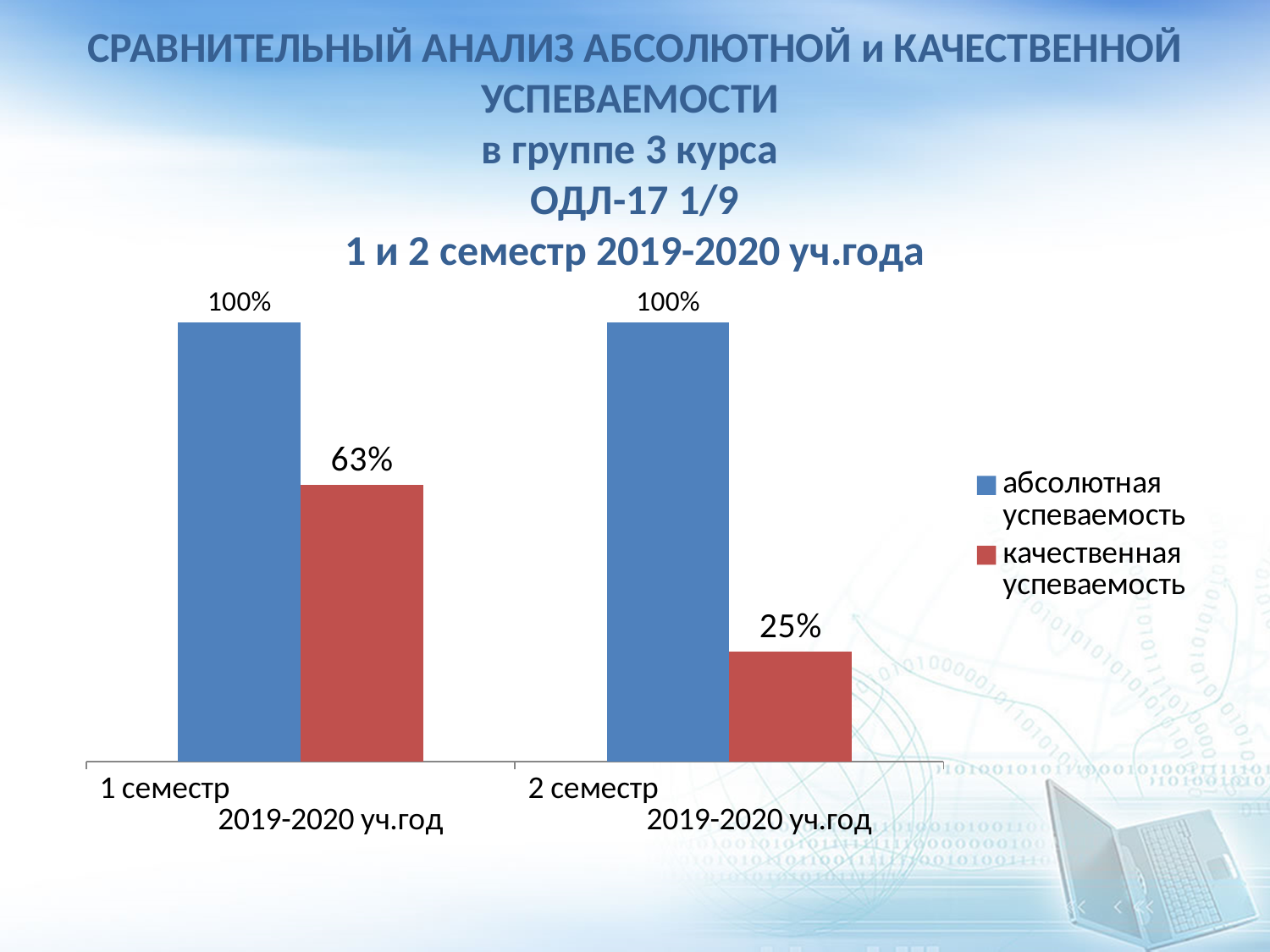
What is the value of качественная успеваемость for 1 семестр 2019-2020 уч.год? 63% In which semester is качественная успеваемость highest? 1 семестр 2019-2020 уч.год What is the value of качественная успеваемость for 2 семестр 2019-2020 уч.год? 25% Does качественная успеваемость rise or fall from 1 семестр to 2 семестр? fall What is the value of абсолютная успеваемость for 2 семестр 2019-2020 уч.год? 100% What is the difference between качественная успеваемость in 1 семестр and 2 семестр? 38% How many series does the legend list? 2 What kind of chart is shown on the slide? bar chart How many categories (semesters) are shown on the x axis? 2 Which is larger in 2 семестр: абсолютная успеваемость or качественная успеваемость? абсолютная успеваемость What is the value of абсолютная успеваемость for 1 семестр 2019-2020 уч.год? 100% In which semester is качественная успеваемость lowest? 2 семестр 2019-2020 уч.год